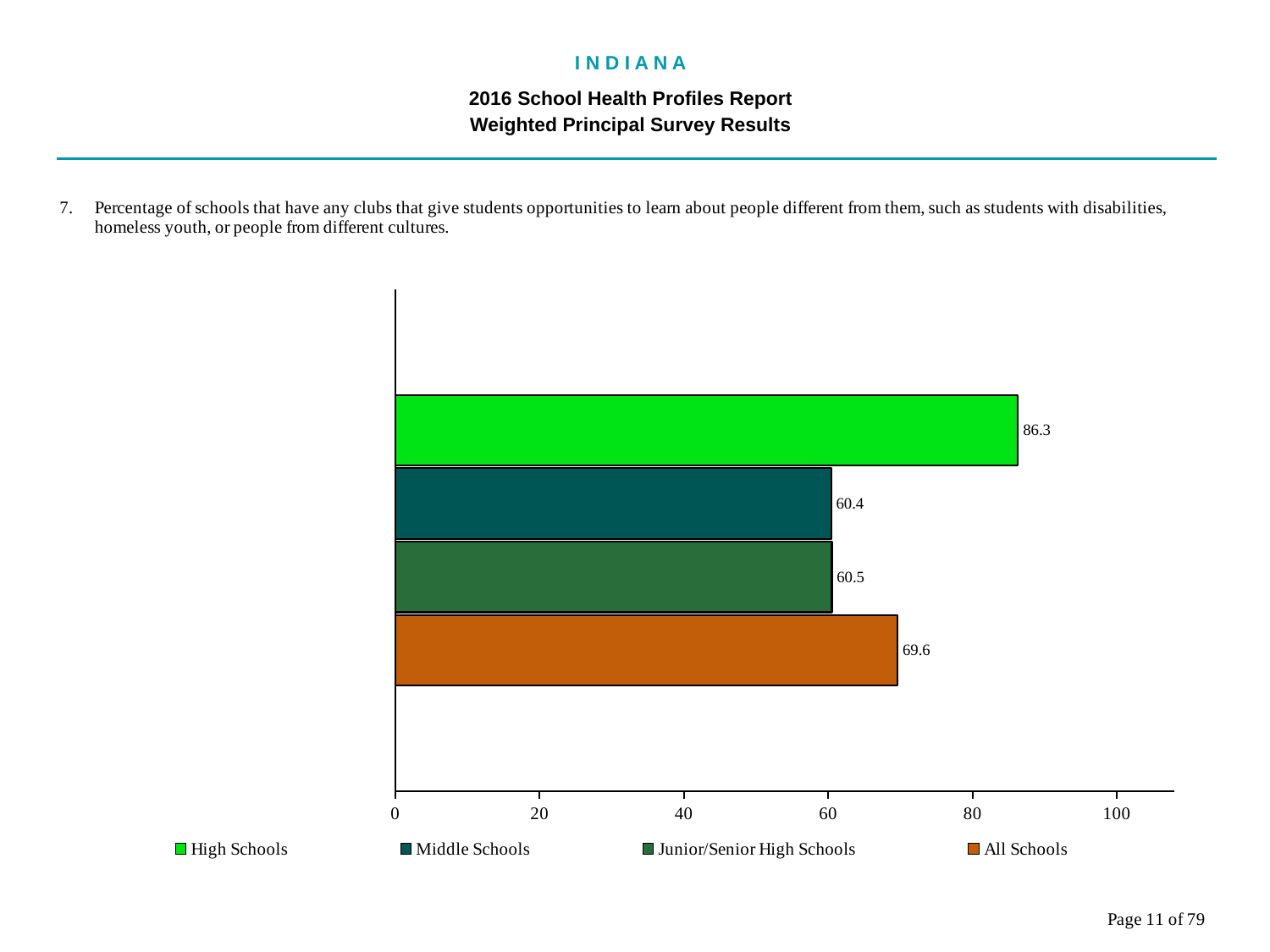
What is the difference between the All Schools value and the Middle Schools value? 9.2 What is the value for Middle Schools? 60.4 How many bars are plotted in the chart? 4 Which school type has the highest value? High Schools What is the difference between the High Schools value and the All Schools value? 16.7 What is the value for High Schools? 86.3 What kind of chart is shown on the slide? bar chart Is the value for All Schools greater or less than 60? greater How many entries does the legend list? 4 Which is larger, the value for High Schools or the value for All Schools? High Schools What is the value for Junior/Senior High Schools? 60.5 What is the value for All Schools? 69.6